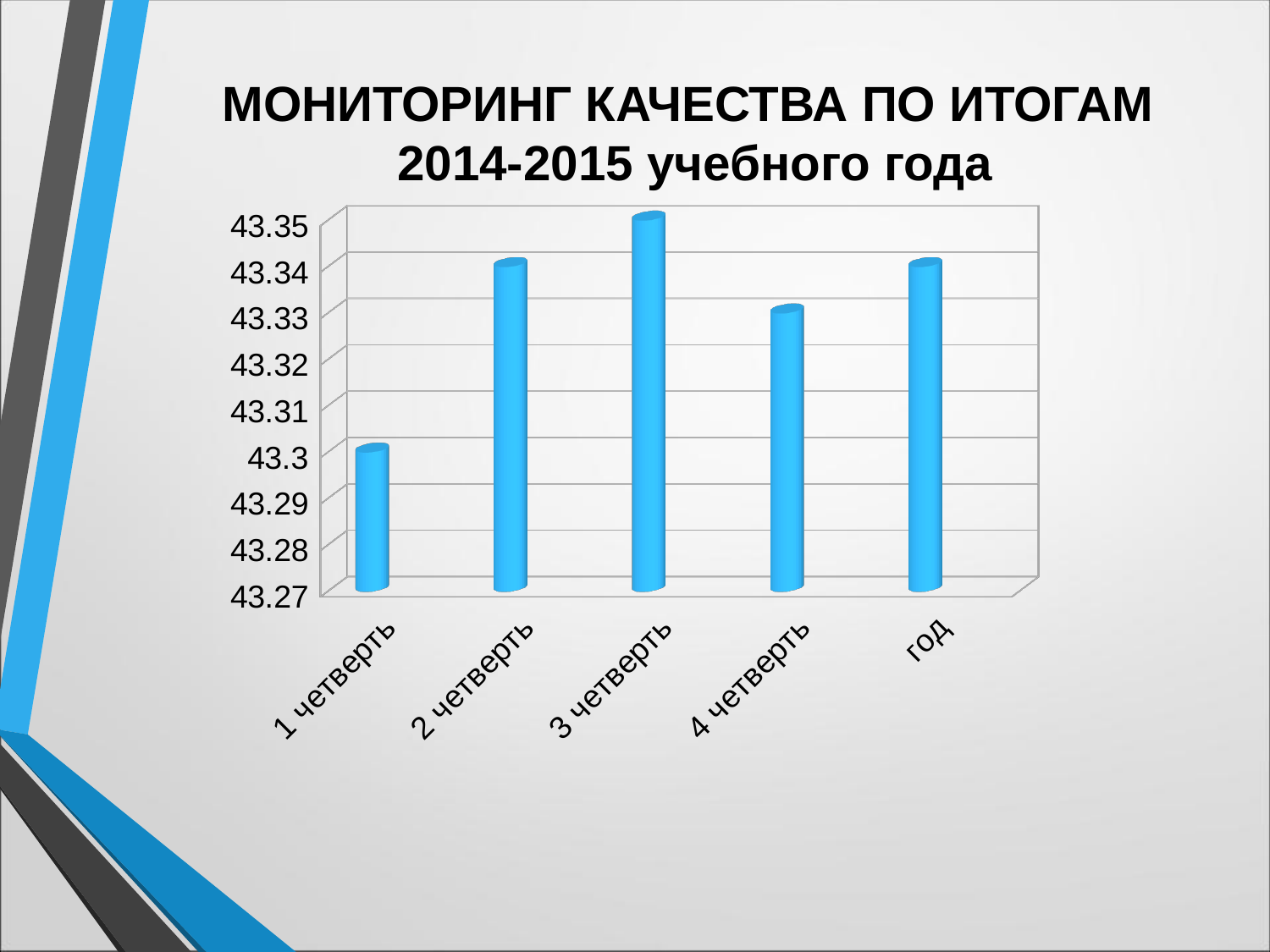
Is the value for год greater or less than 43.33? greater What is the title of the slide containing the chart? МОНИТОРИНГ КАЧЕСТВА ПО ИТОГАМ 2014-2015 учебного года Is the value for 1 четверть greater or less than 43.31? less Which category has the lowest bar in the chart? 1 четверть Is the value for 4 четверть greater or less than 43.32? greater What is the lowest value shown on the y axis of the chart? 43.27 Which is larger, the value for 1 четверть or the value for 3 четверть? 3 четверть Which is larger, the value for 2 четверть or the value for 4 четверть? 2 четверть What kind of chart is shown on the slide? bar chart How many categories are shown on the x axis of the chart? 5 Which category has the highest bar in the chart? 3 четверть